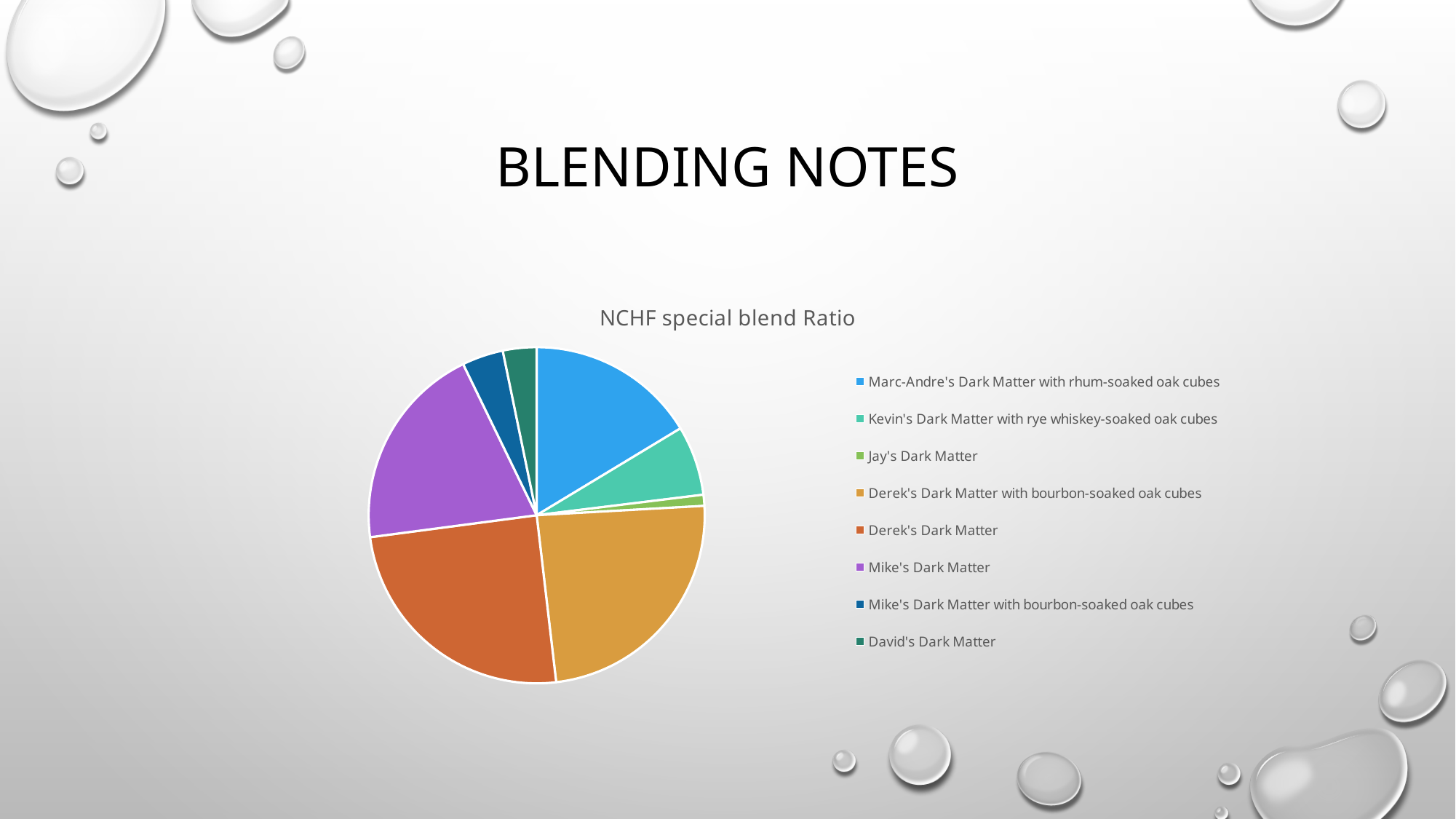
Which category has the smallest slice of the pie? Jay's Dark Matter Which slice is larger: Mike's Dark Matter or Marc-Andre's Dark Matter with rhum-soaked oak cubes? Mike's Dark Matter What kind of chart is shown on the slide? pie chart What colour is the slice for Derek's Dark Matter with bourbon-soaked oak cubes? gold/orange-yellow How many categories (slices) does the pie chart have? 8 Which slice is larger: Mike's Dark Matter or Mike's Dark Matter with bourbon-soaked oak cubes? Mike's Dark Matter Which slice is larger: David's Dark Matter or Jay's Dark Matter? David's Dark Matter What is the title of the chart? NCHF special blend Ratio